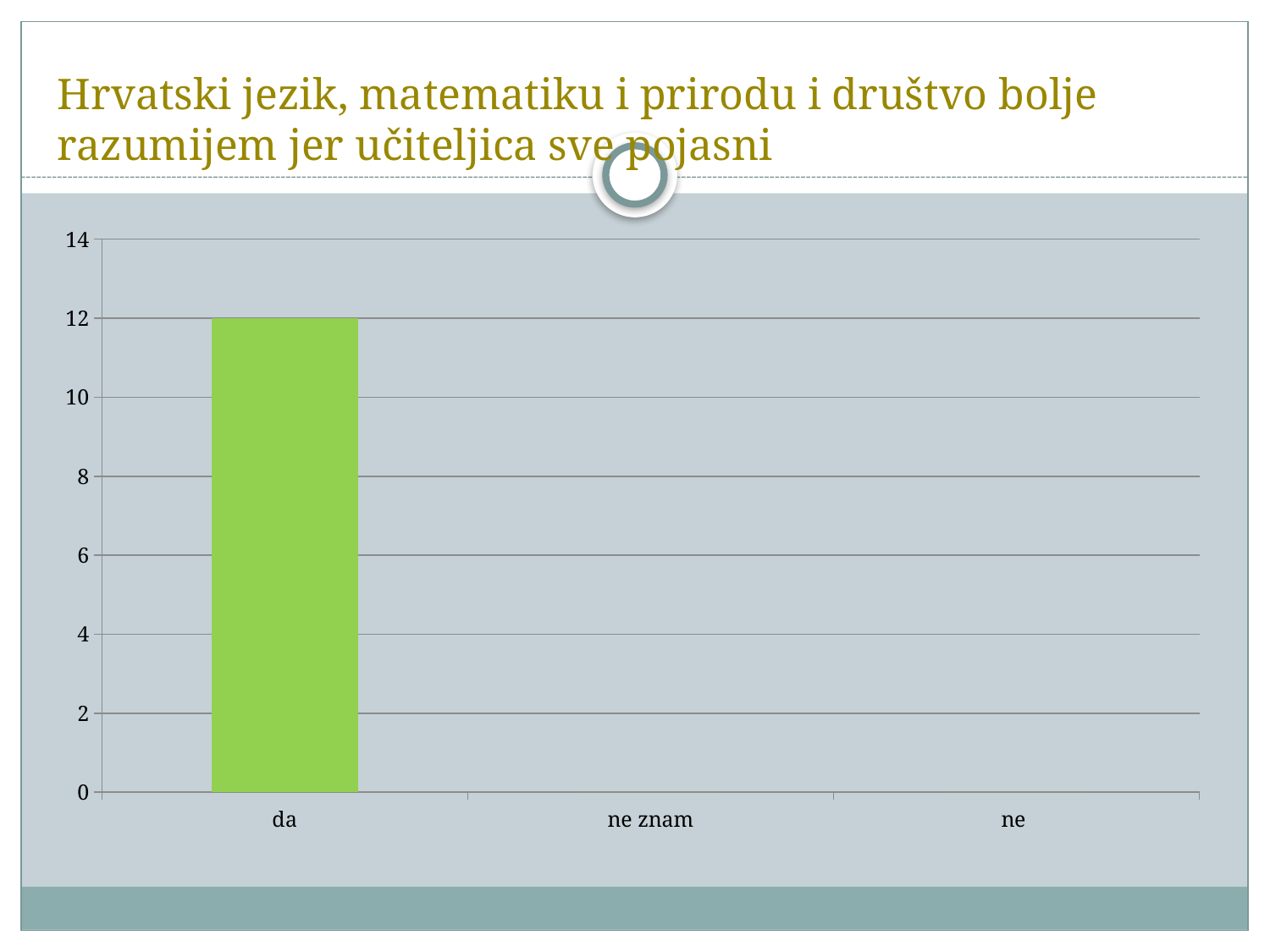
What type of chart is shown on the slide? bar chart Is the value for "da" greater or less than 10? greater Which is larger, the value for "da" or the value for "ne znam"? da Which is larger, the value for "da" or the value for "ne"? da Which category has the highest value? da What is the value for "ne"? 0 What colour is the bar for "da"? green How many categories are shown on the x axis? 3 What is the highest value shown on the vertical axis? 14 What is the value for "da"? 12 Is the value for "da" greater or less than 14? less